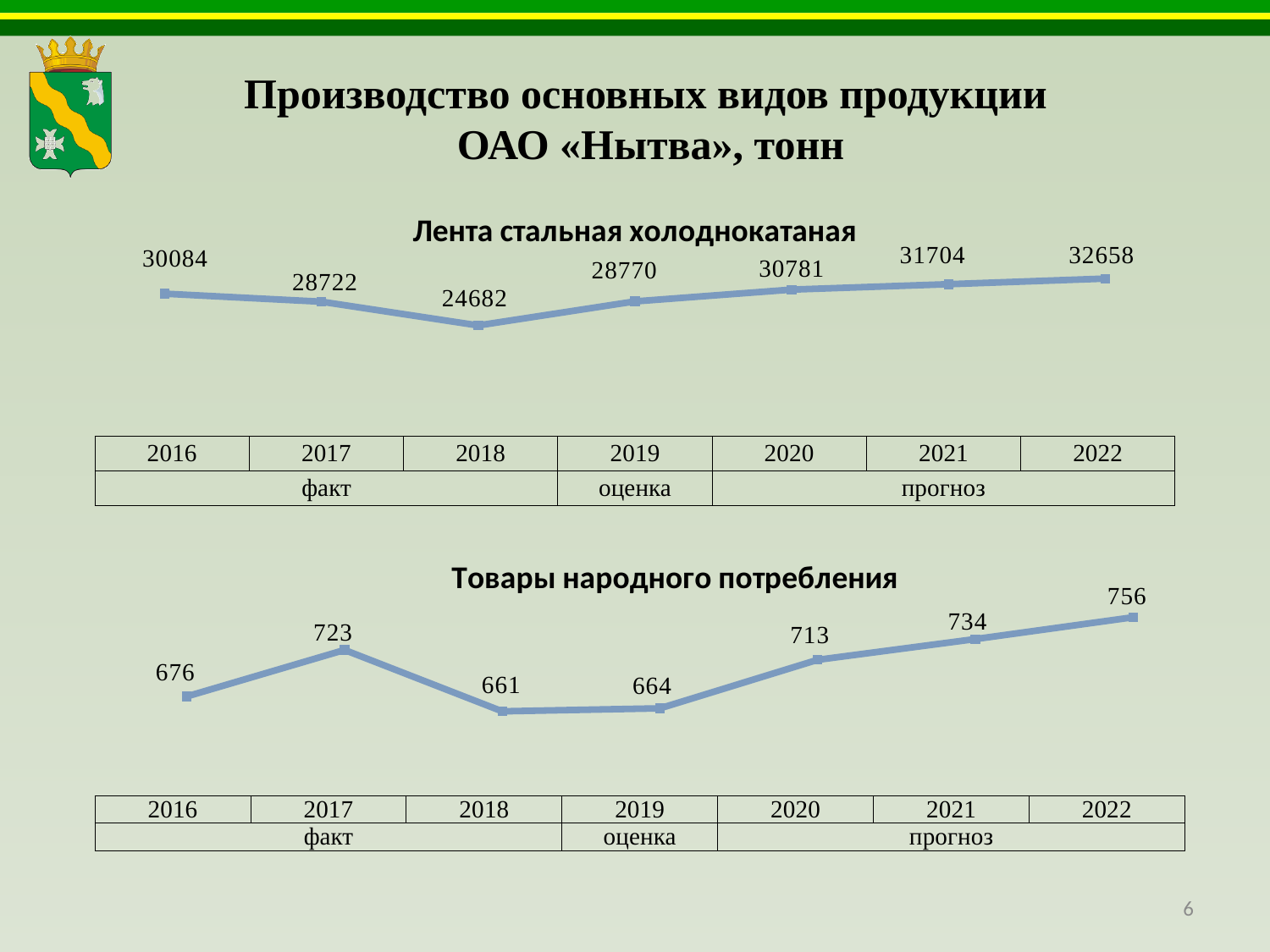
In the chart titled «Лента стальная холоднокатаная», which year has the highest value? 2022 In the chart titled «Лента стальная холоднокатаная», what is the value for 2018? 24682 In the chart titled «Лента стальная холоднокатаная», what is the difference between the values for 2022 and 2021? 954 In the chart titled «Товары народного потребления», which is larger, the value for 2017 or the value for 2021? 2021 In the chart titled «Товары народного потребления», what is the value for 2020? 713 In the chart titled «Лента стальная холоднокатаная», which year has the lowest value? 2018 In the chart titled «Товары народного потребления», which year has the lowest value? 2018 In the chart titled «Лента стальная холоднокатаная», do the values rise or fall from 2018 to 2022? rise In the chart titled «Лента стальная холоднокатаная», how many data points are plotted? 7 In the chart titled «Товары народного потребления», which year has the highest value? 2022 In the chart titled «Товары народного потребления», what is the difference between the values for 2017 and 2016? 47 What type of chart is used for «Товары народного потребления»? line chart